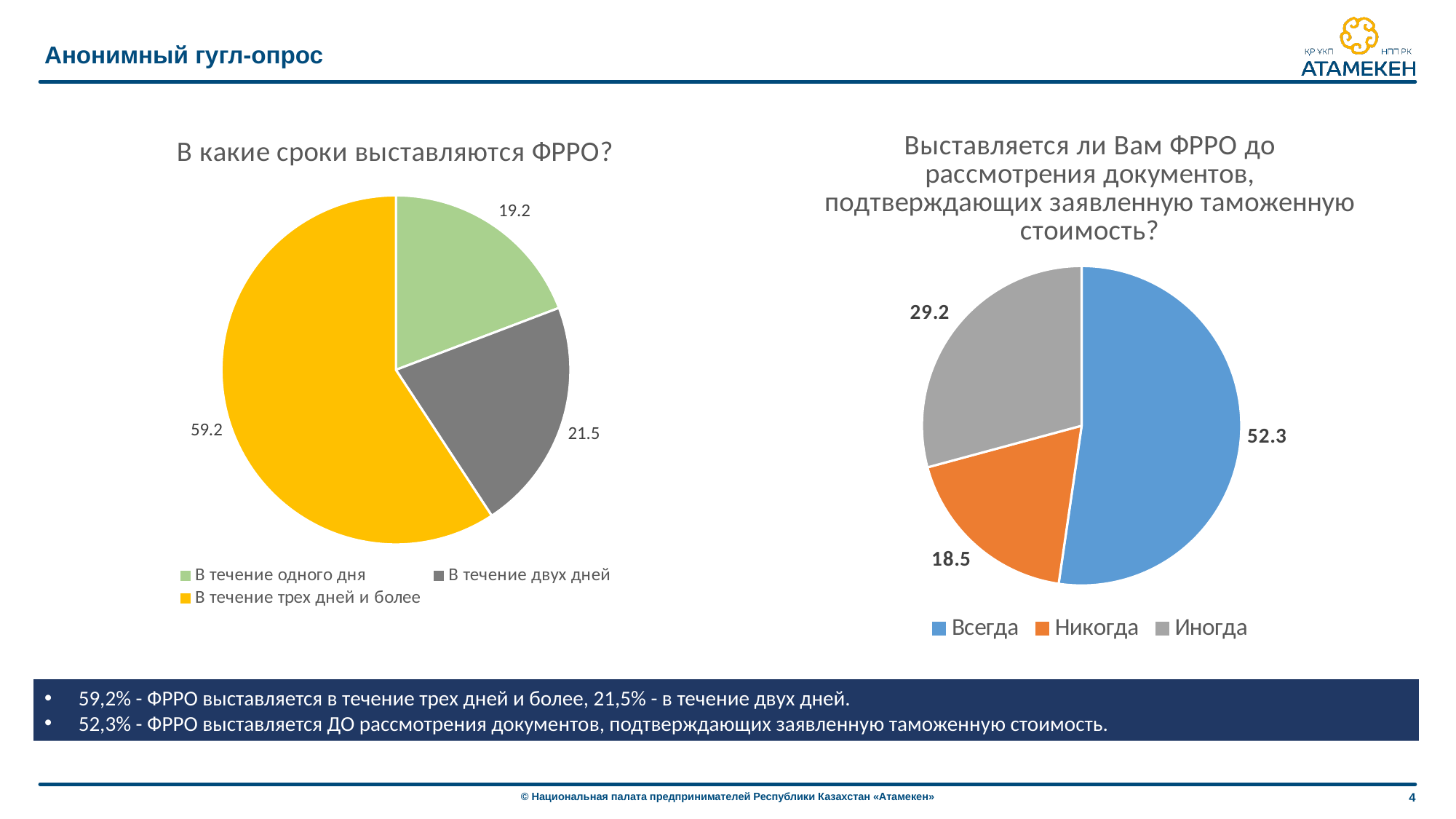
In the right chart about whether ФРРО is issued before document review, which category has the smallest slice? Никогда In the left chart 'В какие сроки выставляются ФРРО?', what is the value for 'В течение трех дней и более'? 59.2 In the right chart about whether ФРРО is issued before document review, what is the value for 'Всегда'? 52.3 In the right chart about whether ФРРО is issued before document review, which is larger: 'Иногда' or 'Никогда'? Иногда How many categories does the left pie chart 'В какие сроки выставляются ФРРО?' show? 3 In the left chart 'В какие сроки выставляются ФРРО?', which category has the smallest slice? В течение одного дня In the right chart about whether ФРРО is issued before document review, what is the difference between 'Всегда' and 'Иногда'? 23.1 In the left chart 'В какие сроки выставляются ФРРО?', what is the value for 'В течение одного дня'? 19.2 What type of chart is the right chart about whether ФРРО is issued before document review? Pie chart In the left chart 'В какие сроки выставляются ФРРО?', what is the difference between the values for 'В течение двух дней' and 'В течение одного дня'? 2.3 In the right chart about whether ФРРО is issued before document review, what is the value for 'Никогда'? 18.5 In the left chart 'В какие сроки выставляются ФРРО?', which category has the largest slice? В течение трех дней и более